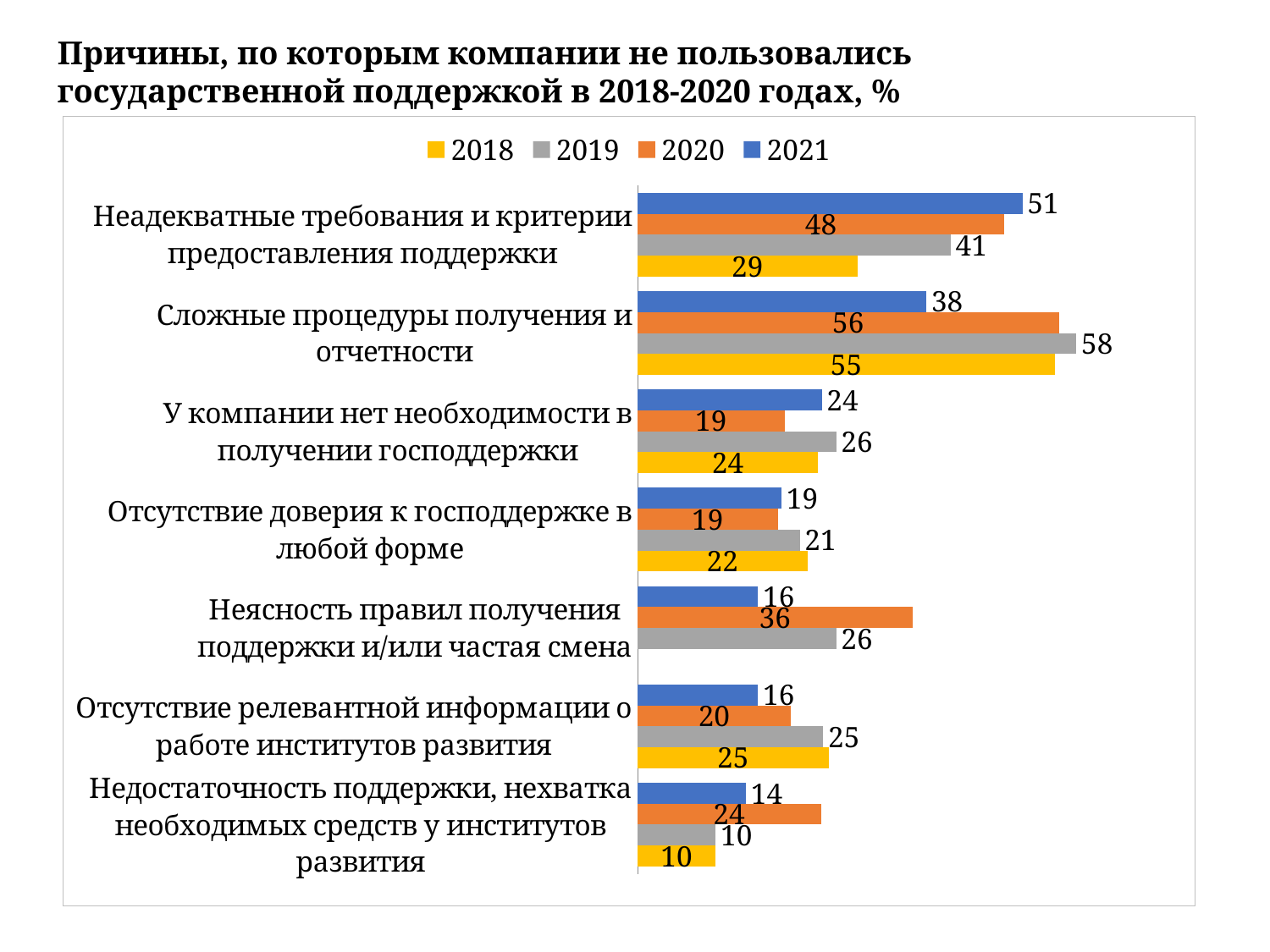
What is the 2020 value for "Неясность правил получения поддержки и/или частая смена"? 36 Which category has the highest 2021 value? Неадекватные требования и критерии предоставления поддержки Which series is shown in yellow in the legend? 2018 For "Сложные процедуры получения и отчетности", which is larger: the 2020 value or the 2021 value? 2020 What type of chart is shown on the slide? Bar chart What is the difference between the 2021 and 2018 values for "Неадекватные требования и критерии предоставления поддержки"? 22 How many categories (reasons) are shown on the chart? 7 What is the 2021 value for "Неадекватные требования и критерии предоставления поддержки"? 51 What is the 2019 value for "Сложные процедуры получения и отчетности"? 58 How does the value for "Неадекватные требования и критерии предоставления поддержки" change from 2018 to 2021? It rises Which category has the lowest 2018 value? Недостаточность поддержки, нехватка необходимых средств у институтов развития How many series does the legend list? 4